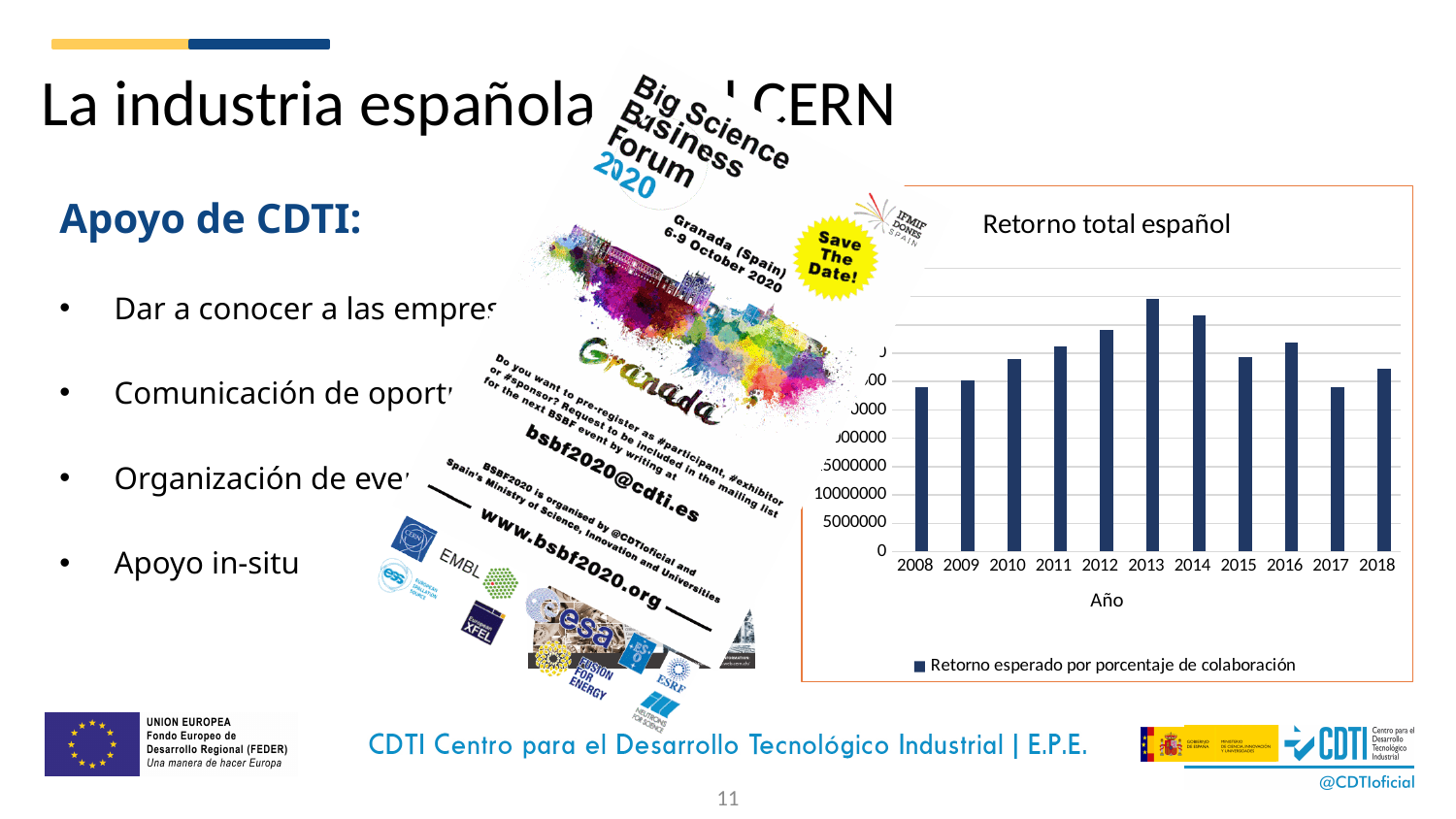
How many series does the chart's legend list? 1 Which year has the larger value, 2016 or 2017? 2016 Is the value for 2008 greater or less than 10000000? greater Which year has the highest value in the chart? 2013 Which year has the larger value, 2014 or 2015? 2014 How many years are shown on the x axis of the chart? 11 Which year has the larger value, 2013 or 2008? 2013 What kind of chart is shown on the slide? bar chart What is the legend entry of the chart? Retorno esperado por porcentaje de colaboración Is the value for 2017 greater or less than 5000000? greater Do the values rise or fall from 2008 to 2013? rise What is the title of the chart on the slide? Retorno total español